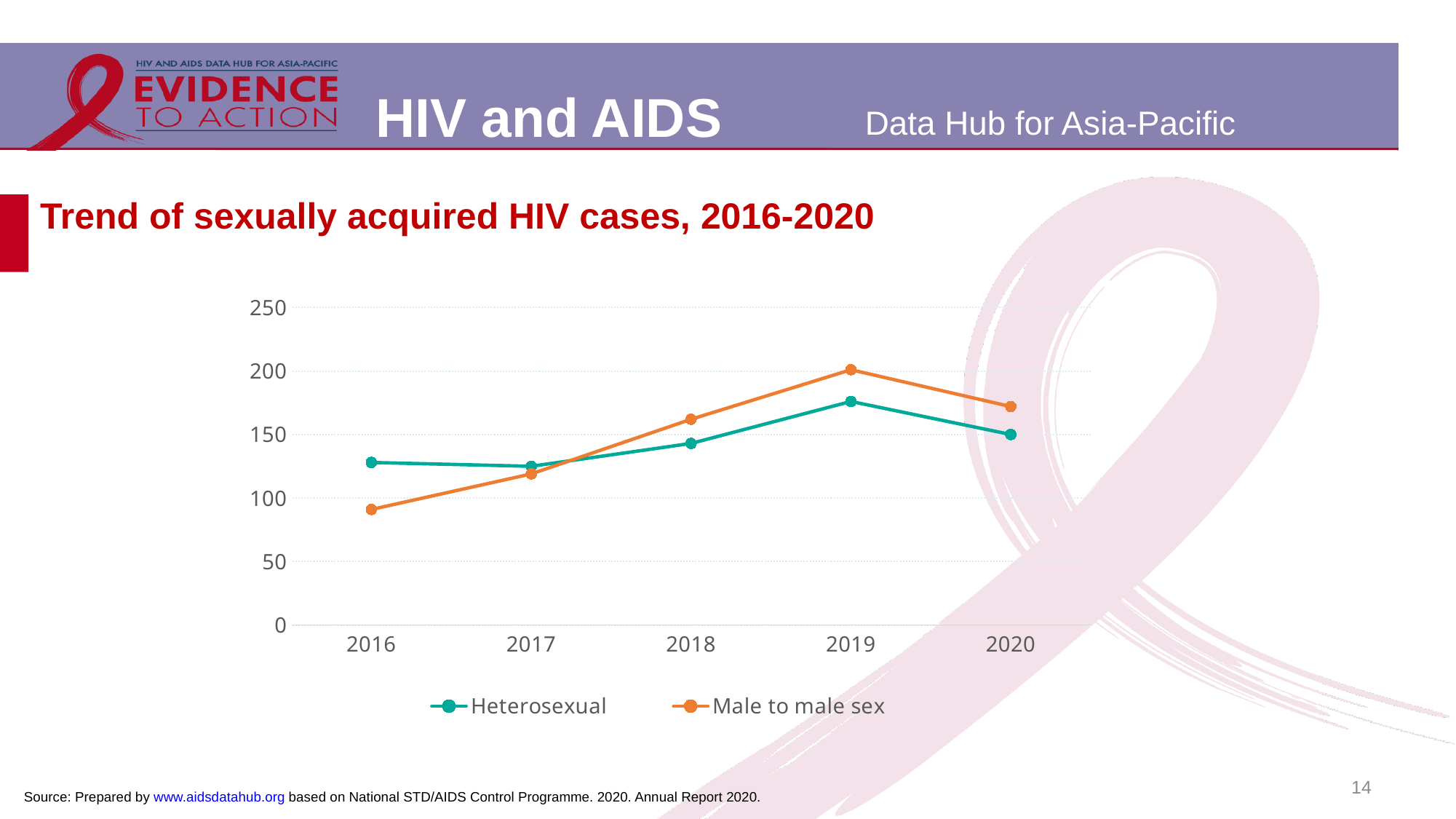
In 2019, which series has the larger value, Heterosexual or Male to male sex? Male to male sex Is the value for Male to male sex in 2016 greater or less than 100? less Does the Male to male sex series rise or fall from 2016 to 2019? rise How many years are plotted on the x axis? 5 In which year is the Male to male sex series at its lowest value? 2016 How many series does the legend list? 2 Is the value for Heterosexual in 2019 greater or less than 150? greater In which year does the Heterosexual series reach its highest value? 2019 In which year does the Male to male sex series reach its highest value? 2019 In 2016, which series has the larger value, Heterosexual or Male to male sex? Heterosexual What kind of chart is shown on the slide? line chart What is the title of the chart on the slide? Trend of sexually acquired HIV cases, 2016-2020